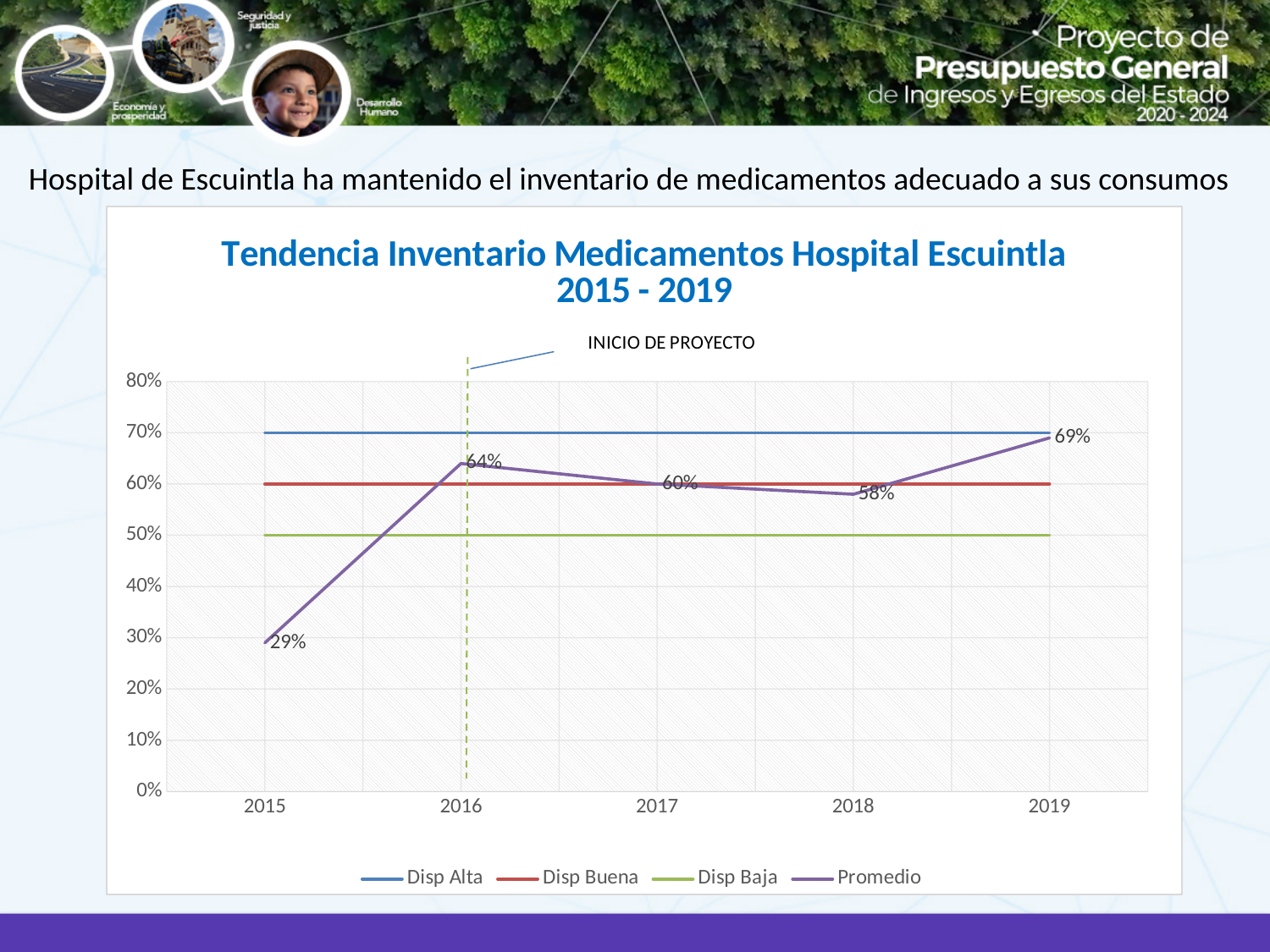
What is the difference between the Promedio values for 2016 and 2015? 35% At what level does the Disp Alta line sit across all years? 70% How many years are shown on the x axis? 5 What is the value of Promedio in 2016? 64% How many series does the legend list? 4 What is the value of Promedio in 2015? 29% What is the value of Promedio in 2019? 69% Is the Promedio value for 2018 greater or less than 50%? greater In which year is the Promedio value highest? 2019 What kind of chart is shown? line chart In which year is the Promedio value lowest? 2015 Which is larger, the Promedio value in 2017 or in 2018? 2017